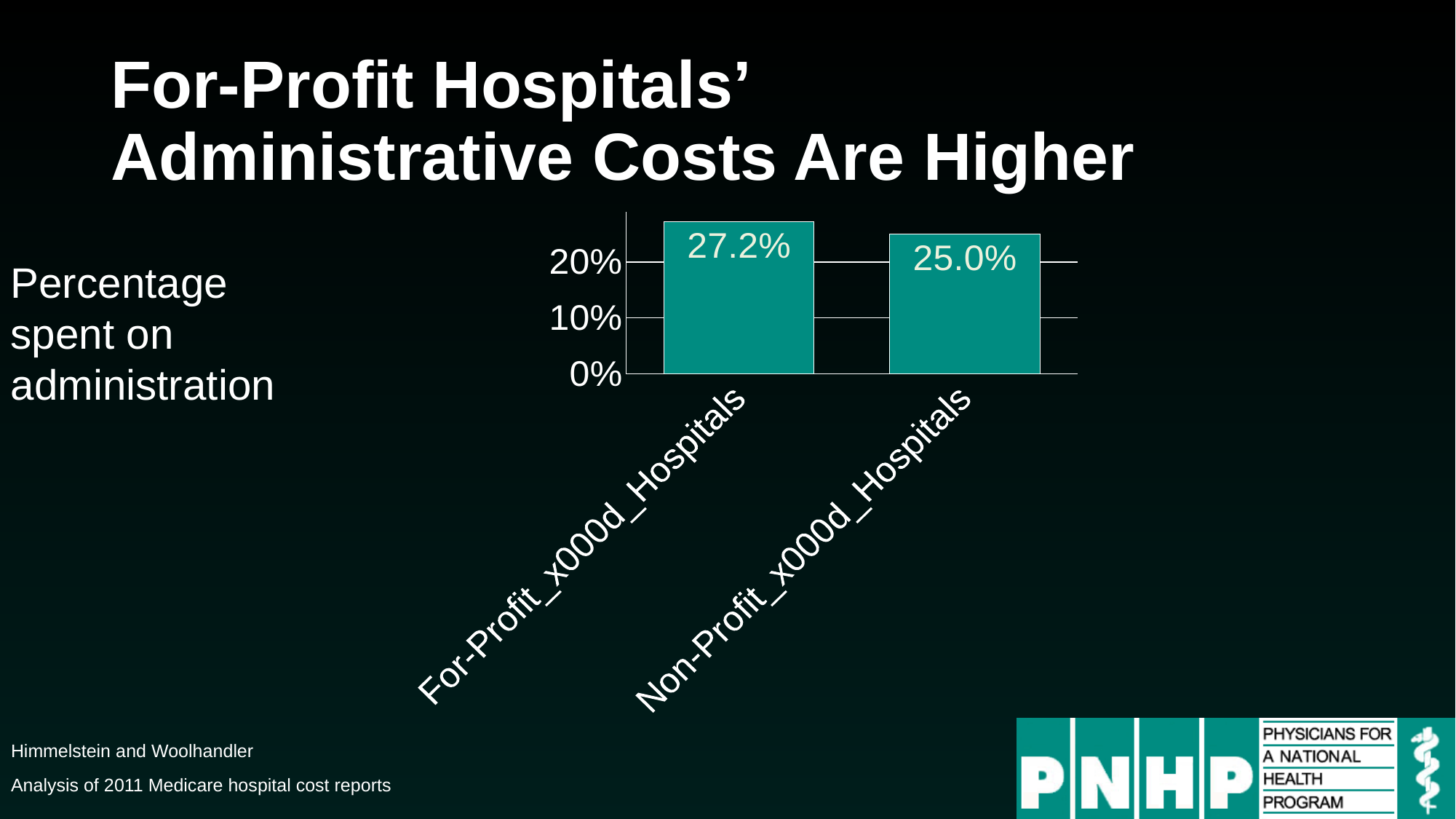
Is the value for For-Profit Hospitals greater or less than 10%? greater Which category has the lowest value? Non-Profit Hospitals What is the value for For-Profit Hospitals? 27.2% Is the value for Non-Profit Hospitals greater or less than 20%? greater What colour are the bars in the chart? teal What kind of chart is shown on the slide? bar chart What is the title of the slide? For-Profit Hospitals' Administrative Costs Are Higher Which is larger, the value for For-Profit Hospitals or Non-Profit Hospitals? For-Profit Hospitals How many categories are shown in the chart? 2 What is the value for Non-Profit Hospitals? 25.0% What is the difference between the values for For-Profit Hospitals and Non-Profit Hospitals? 2.2% Which category has the highest value? For-Profit Hospitals